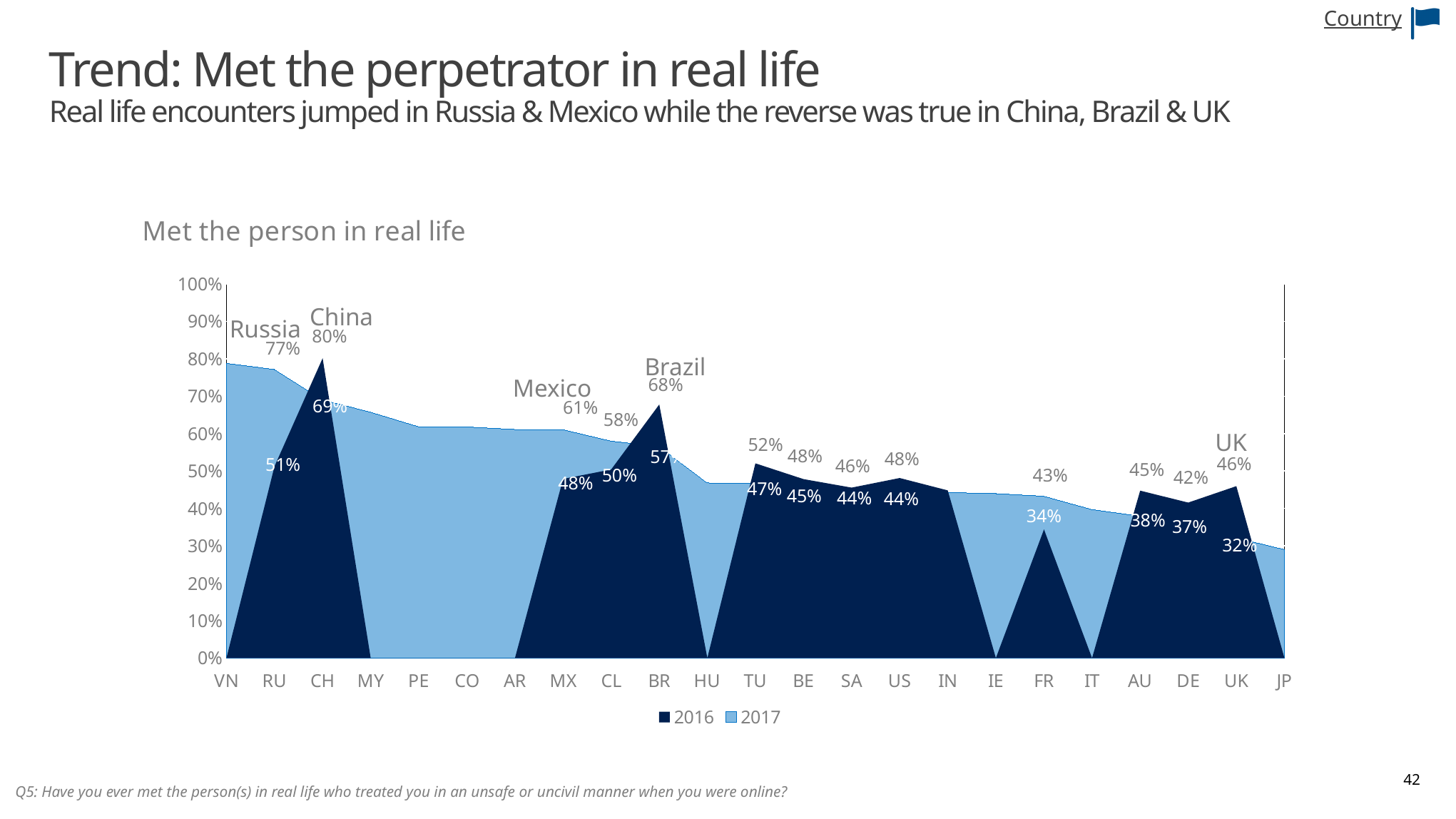
What is the 2016 value for China (CH)? 80% What is the 2016 value for the UK? 46% What is the 2017 value for Mexico (MX)? 61% How many countries are shown along the x axis? 23 How many series does the legend list? 2 Is the 2017 value for Japan (JP) greater or less than 40%? less What kind of chart is shown on the slide? area chart What is the difference between the 2017 and 2016 values for Russia? 26 percentage points Which is larger, the 2016 value for Brazil or the 2016 value for Mexico? Brazil Which country has the highest labelled value on the chart? China What is the 2017 value for Russia (RU)? 77% Do the 2017 values generally rise or fall from VN to JP along the x axis? fall